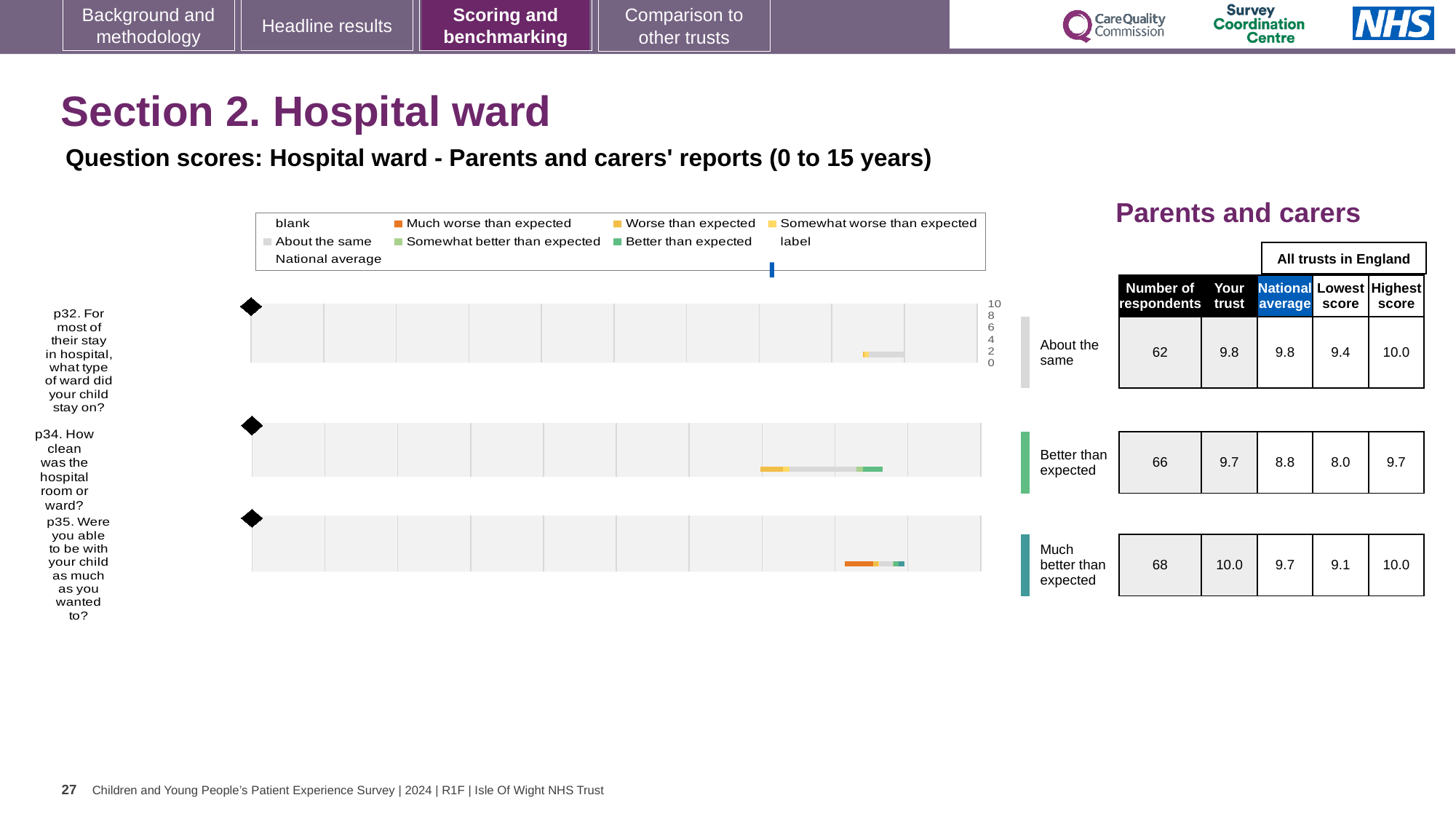
What is the 'Your trust' score for p34 (How clean was the hospital room or ward?)? 9.7 Which benchmark category is p35 rated as? Much better than expected Which has the higher national average score, p32 or p34? p32 What is the lowest score across all trusts in England for p34? 8.0 What colour does the legend use for 'Much worse than expected'? Orange Which question has the highest 'Your trust' score? p35 What kind of chart is used to show the question scores on this slide? Bar chart How many respondents are shown for p35 (Were you able to be with your child as much as you wanted to?)? 68 What is the difference between the 'Your trust' score and the national average for p34? 0.9 What is the highest score across all trusts in England for p32? 10.0 What is the national average score for p34 (How clean was the hospital room or ward?)? 8.8 How many questions (p32, p34, p35) are plotted on the slide? 3